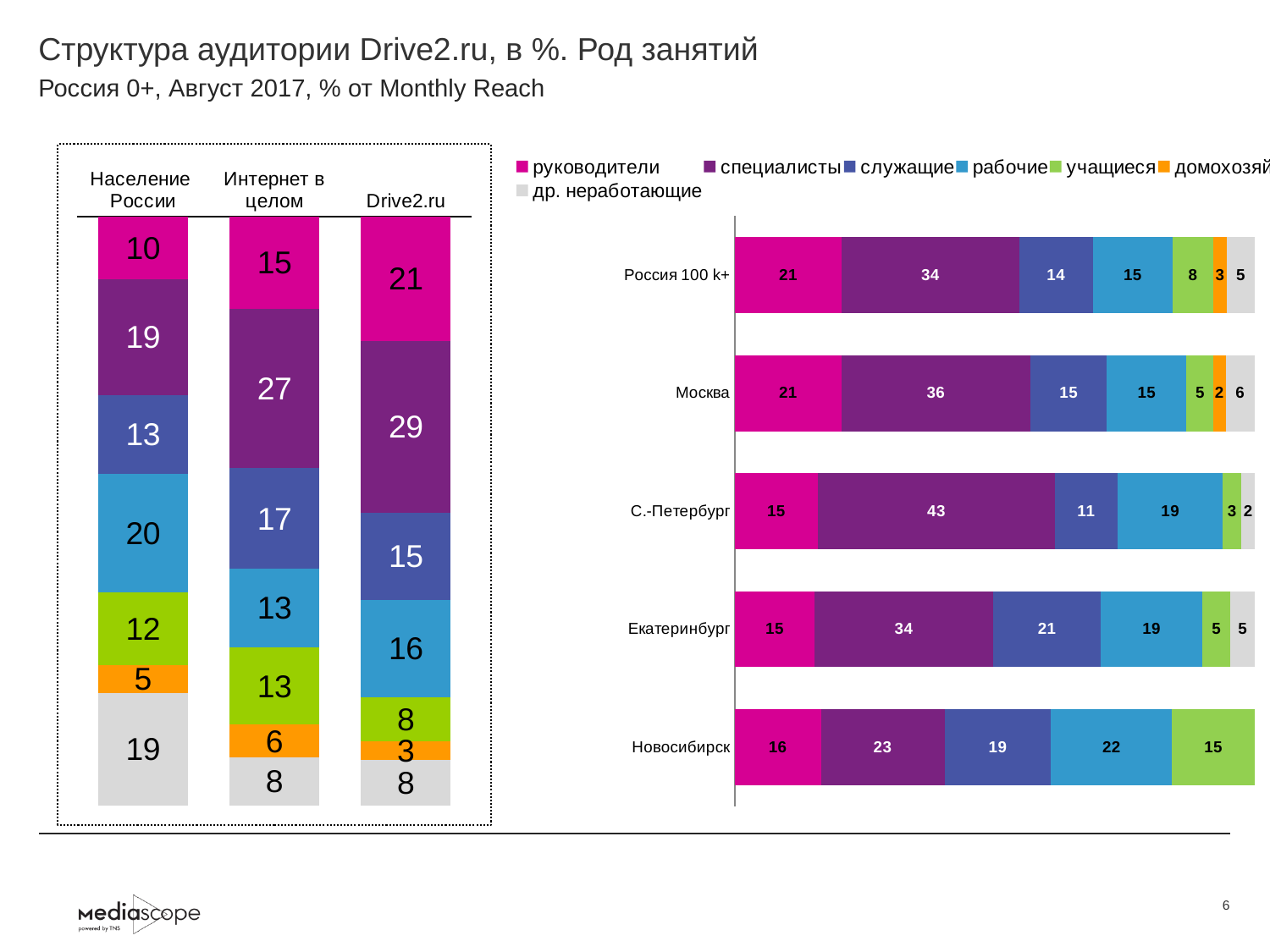
In the right chart, which category has the highest value for специалисты? С.-Петербург In the right chart, what is the value for специалисты for С.-Петербург? 43 In the left chart, what is the difference between the руководители value for Drive2.ru and for Население России? 11 In the left chart, what is the total of the Drive2.ru stacked bar? 100 In the left chart, which has the larger специалисты value: Интернет в целом or Drive2.ru? Drive2.ru How many series does the legend list? 7 In the right chart, which category has the lowest value for специалисты? Новосибирск How many bars (categories) are shown in the right chart? 5 In the left chart, what is the value for специалисты in the Drive2.ru bar? 29 In the right chart, what is the value for рабочие for Новосибирск? 22 How many bars (categories) are shown in the left chart? 3 What kind of chart is the right chart? Stacked bar chart